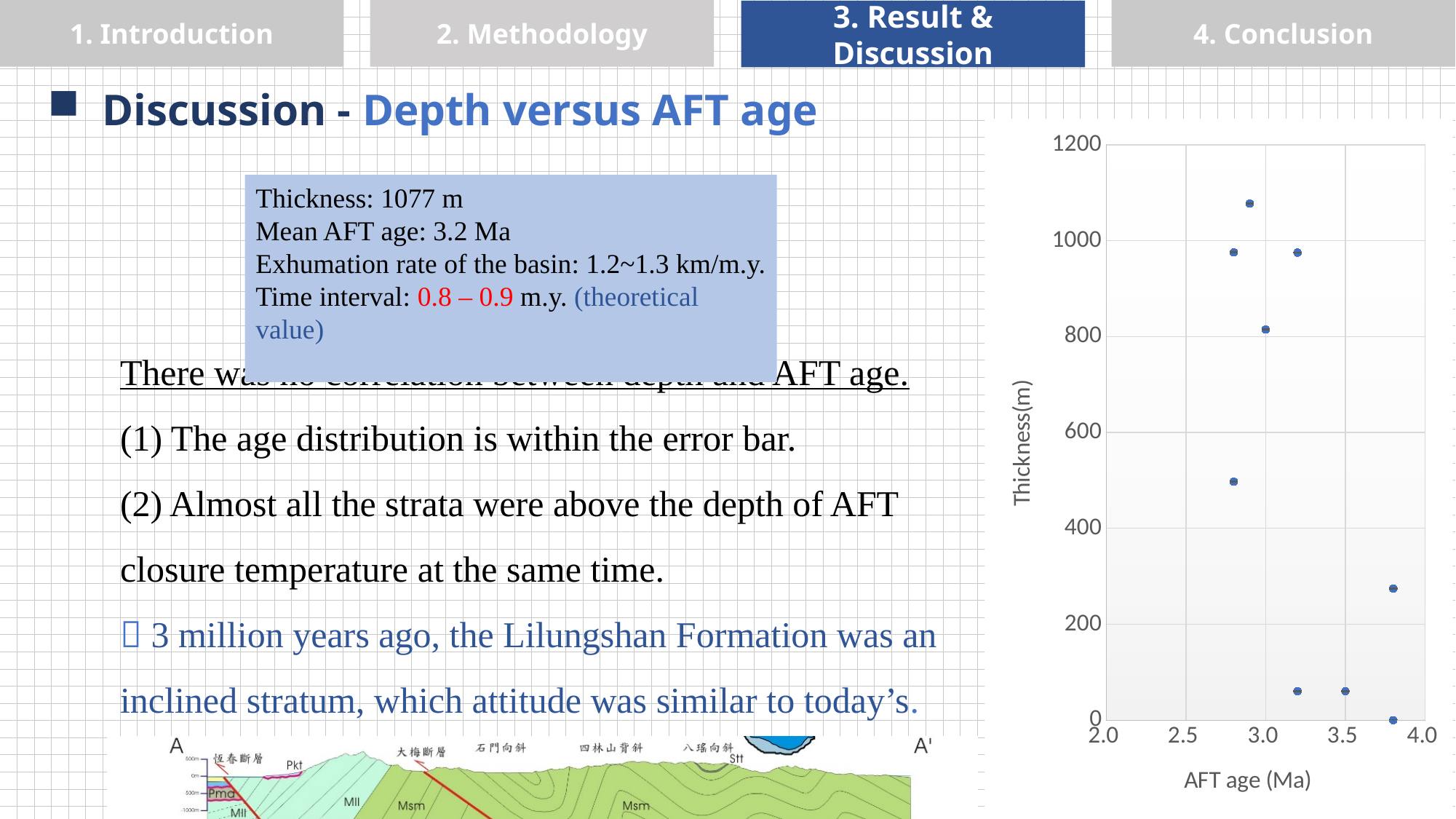
Is the thickness of the point plotted at about 3.8 Ma with the larger thickness greater or less than 400? less What is the label of the horizontal axis of the chart? AFT age (Ma) How many plotted points have a thickness below 200 m? 3 Which has the larger thickness: the point at about 2.9 Ma or the point at about 3.5 Ma? the point at about 2.9 Ma Is the thickness of the highest plotted point greater or less than 1000? greater How many plotted points have a thickness above 600 m? 4 What kind of chart is shown on the right side of the slide? scatter chart Is the thickness of the point plotted at about 2.8 Ma with the smaller thickness greater or less than 600? less What is the maximum value shown on the Thickness(m) axis? 1200 How many data points are plotted in the chart? 9 What is the label of the vertical axis of the chart? Thickness(m) What is the range of the AFT age (Ma) axis? 2.0 to 4.0